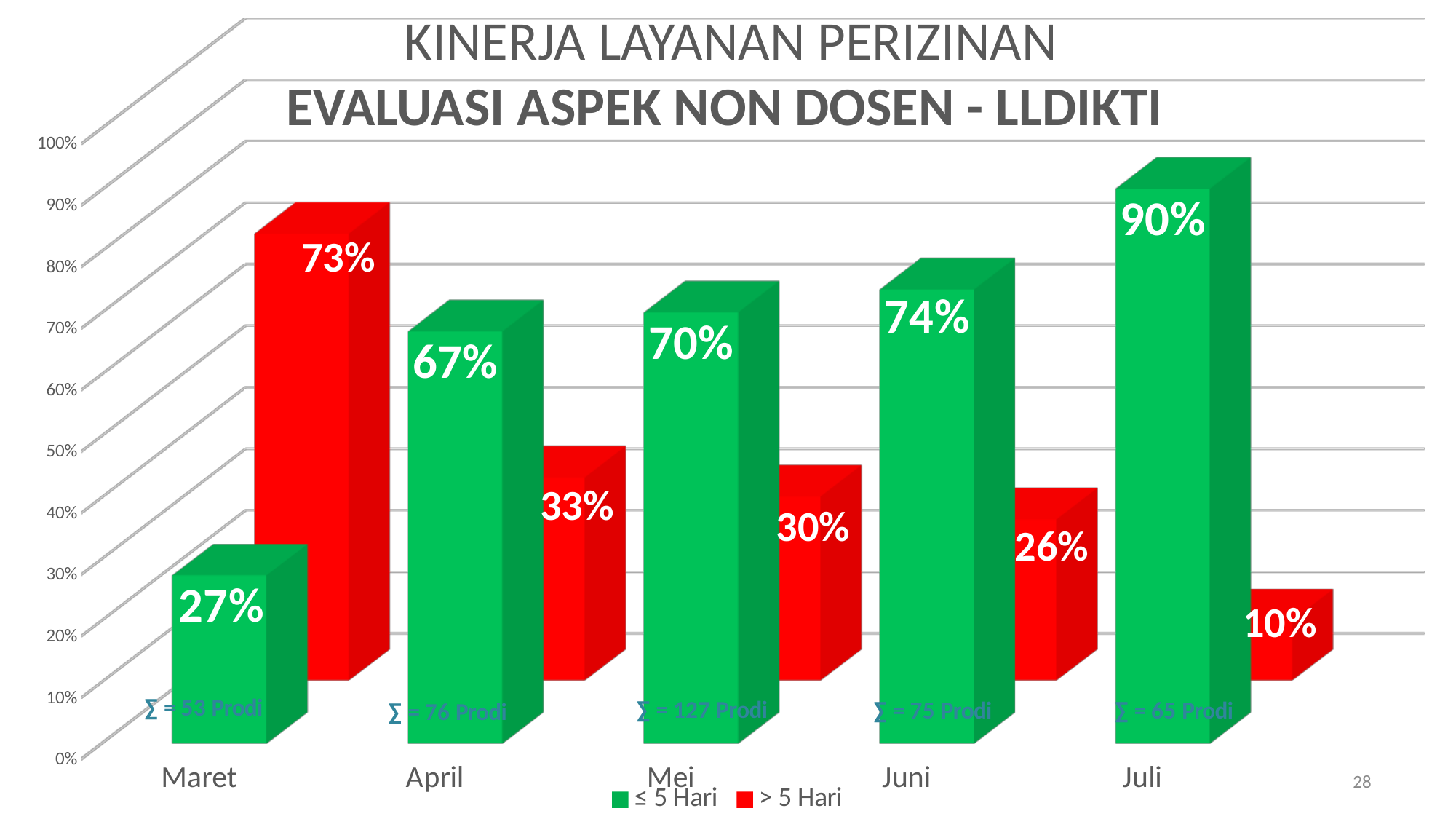
What kind of chart is shown on the slide? Bar chart Which month has the highest value for "≤ 5 Hari"? Juli What is the value for "≤ 5 Hari" in Mei? 70% What is the value for "≤ 5 Hari" in Juli? 90% Which month has the lowest value for "> 5 Hari"? Juli How many series does the legend list? 2 What is the value for "> 5 Hari" in Juni? 26% What is the value for "> 5 Hari" in Maret? 73% How many months are shown on the x axis? 5 What is the difference between the "≤ 5 Hari" values for Juli and Maret? 63% Does the "> 5 Hari" series rise or fall from Maret to Juli? Fall Which is larger in April: the "≤ 5 Hari" value or the "> 5 Hari" value? ≤ 5 Hari